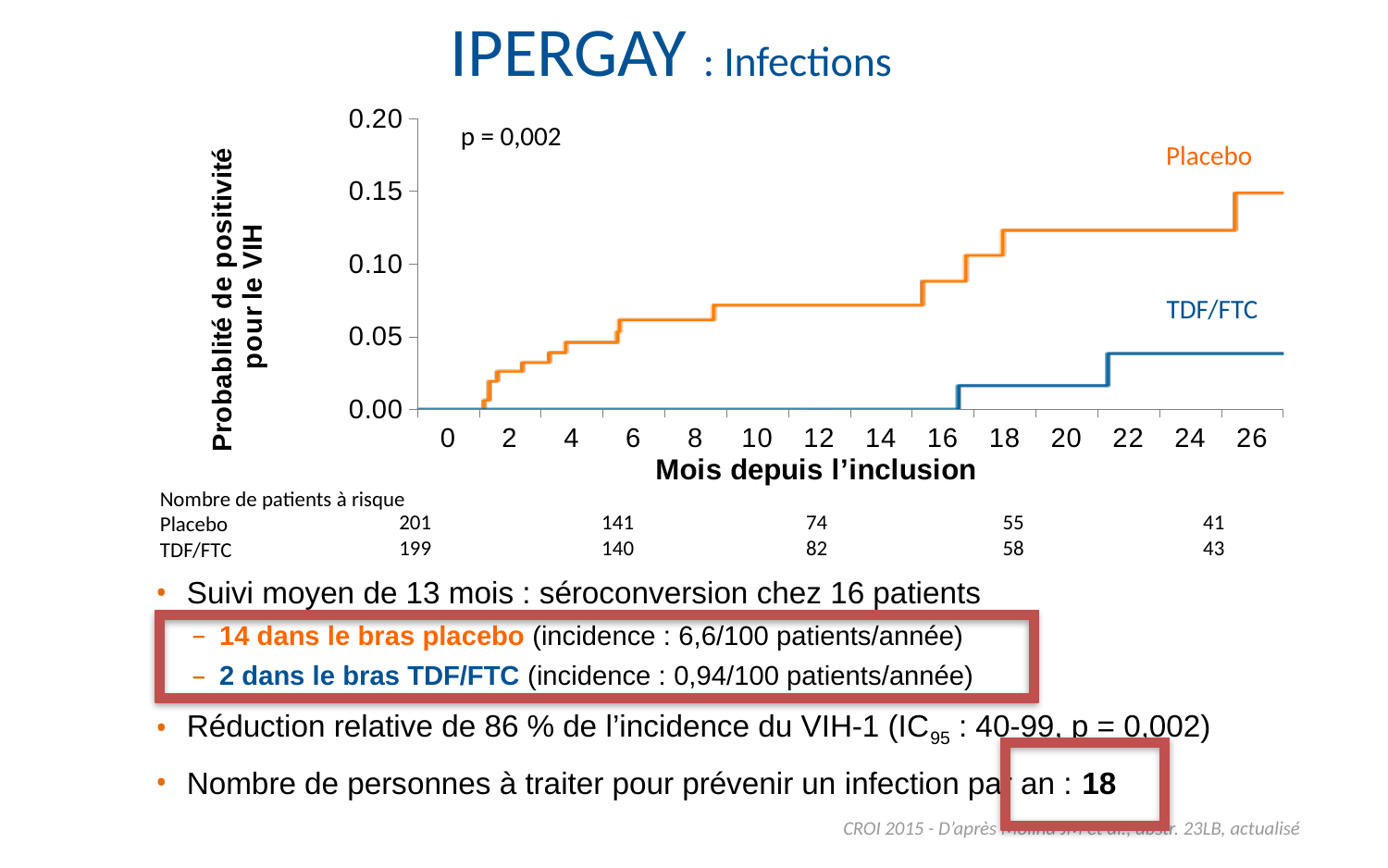
How many Placebo patients were at risk at month 0 according to the table under the chart? 201 What is the difference between the number of TDF/FTC patients at risk (82) and Placebo patients at risk (74) at the third time point in the table? 8 How many series are plotted on the chart? 2 Is the TDF/FTC curve at month 26 greater or less than 0.05? less Do the curves rise or fall as months since inclusion increase? rise Is the Placebo curve at month 26 greater or less than 0.10? greater Is the Placebo curve at month 10 greater or less than 0.05? greater What is the title of the x axis? Mois depuis l'inclusion What p-value is printed on the chart? p = 0,002 How many TDF/FTC patients were at risk at the last time point in the table under the chart? 43 Which series has the higher probability of HIV positivity at month 26, Placebo or TDF/FTC? Placebo What kind of chart is shown on the slide? line chart